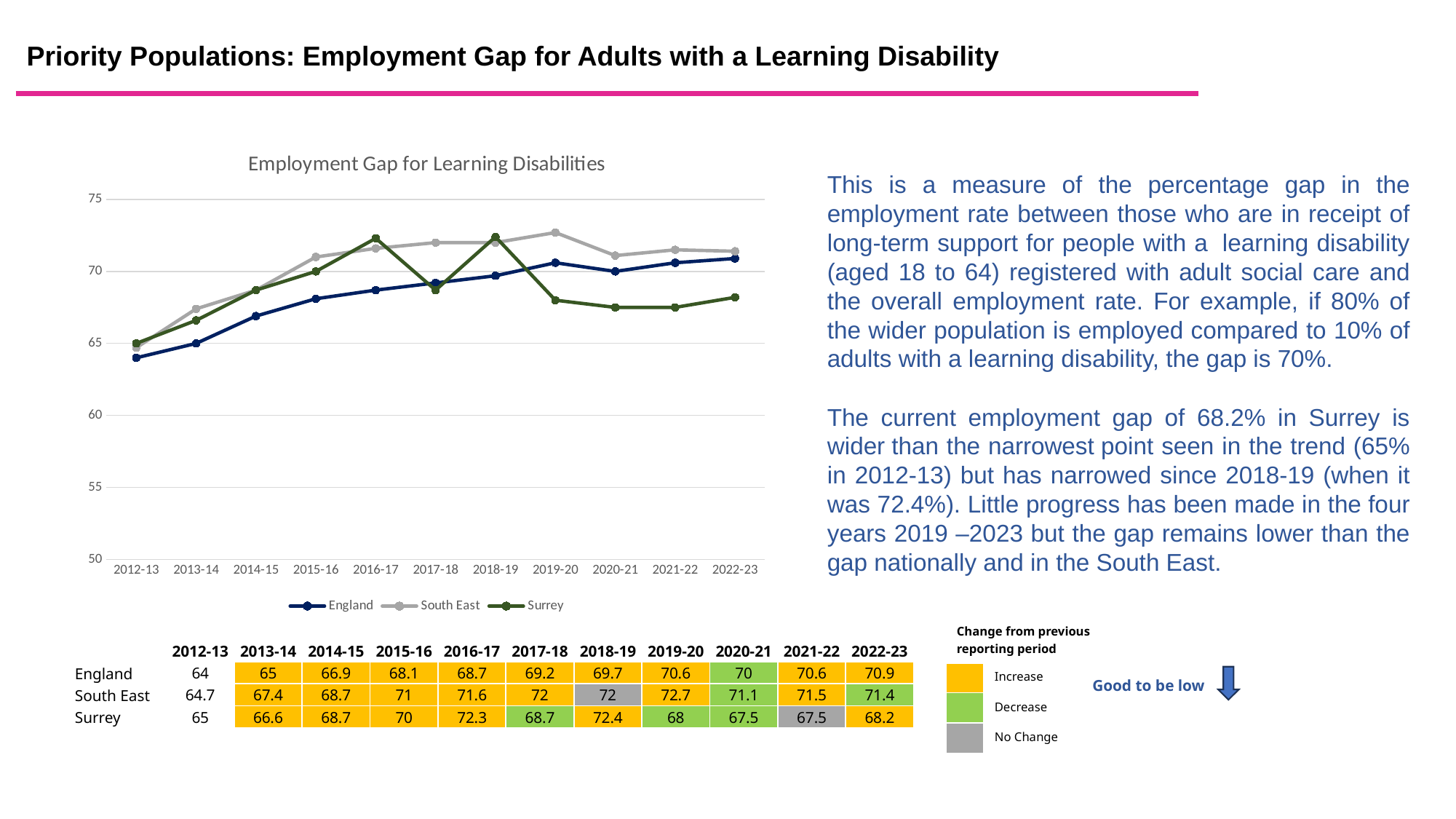
What is the employment gap value for the South East in 2019-20? 72.7 How many series does the legend of the chart list? 3 How many reporting periods are shown along the x axis of the chart? 11 Is the value for Surrey in 2016-17 greater or less than 70? greater In 2022-23, which is larger: the England value or the Surrey value? England What kind of chart is shown on the slide? line chart In which reporting period is the England value lowest? 2012-13 What is the difference between the England value in 2022-23 and in 2012-13? 6.9 What is the title of the chart? Employment Gap for Learning Disabilities What is the employment gap value for England in 2017-18? 69.2 In which reporting period is the South East value highest? 2019-20 What is the employment gap value for Surrey in 2022-23? 68.2